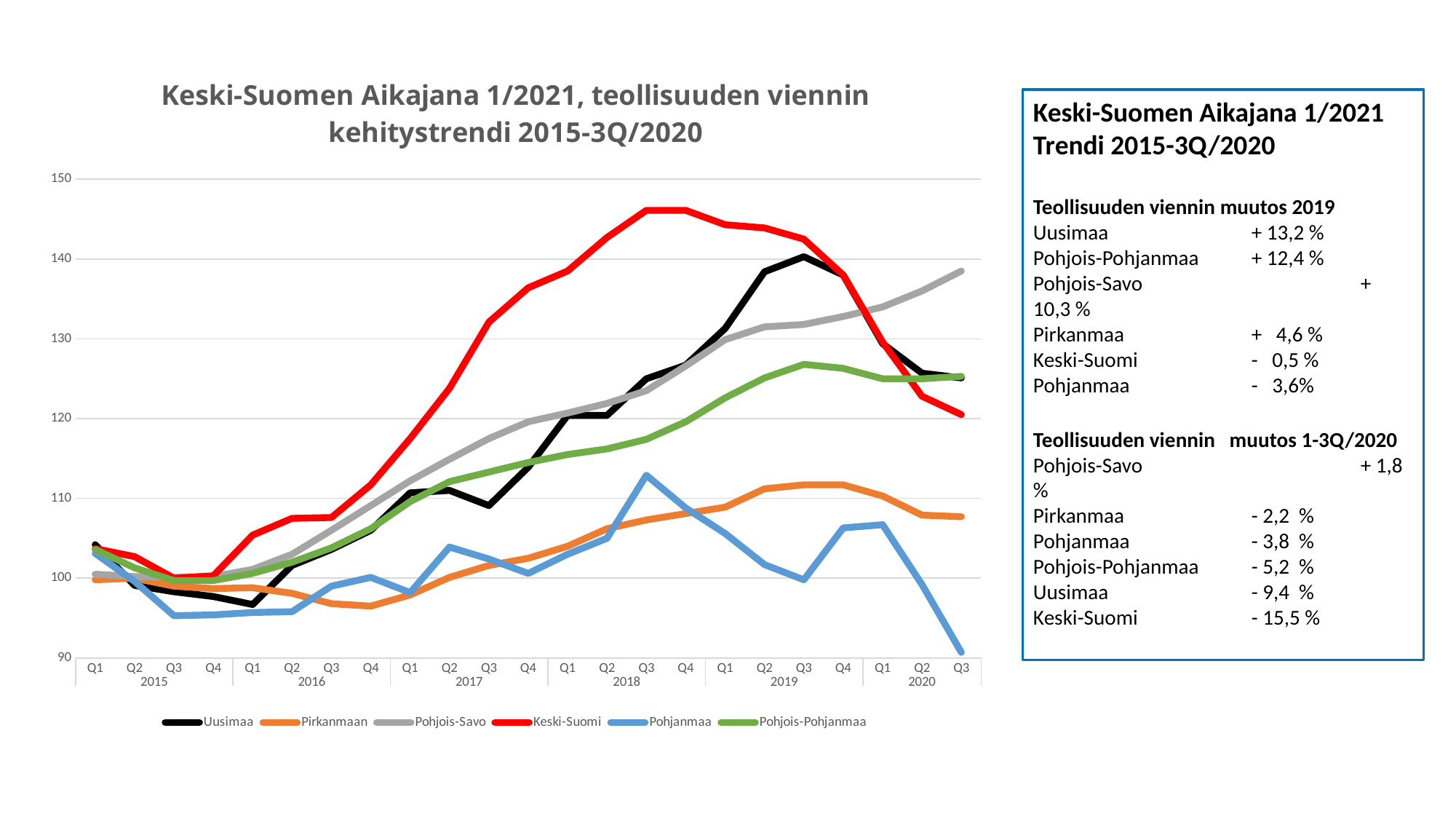
What kind of chart is shown on the slide? Line chart In Q3 2018, which is larger: the value for Keski-Suomi or the value for Pohjanmaa? Keski-Suomi Is the value for Pohjanmaa in Q3 2020 greater or less than 100? less Is the value for Pohjois-Savo in Q3 2020 greater or less than 130? greater Is the value for Keski-Suomi in Q3 2018 greater or less than 140? greater How many series does the chart legend list? 6 Which series has the highest value in Q3 2018? Keski-Suomi Which series has the lowest value in Q3 2020? Pohjanmaa Does the Keski-Suomi line rise or fall from Q3 2018 to Q3 2020? Fall How many quarterly points are plotted along the x axis of the chart? 23 Which series has the highest value in Q3 2020? Pohjois-Savo Which colour is used for the Keski-Suomi series in the chart? Red